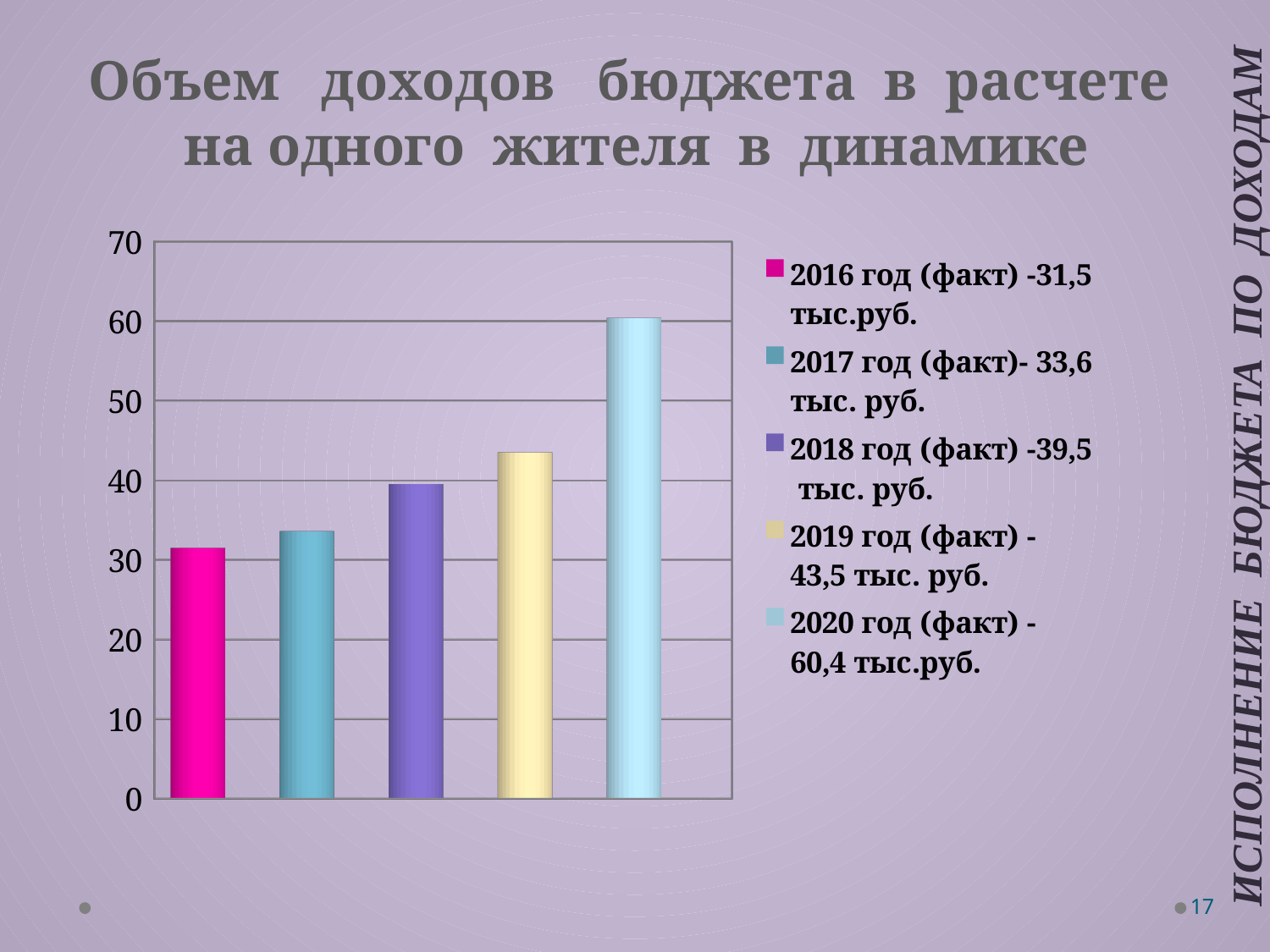
Which year has the highest value? 2020 год (факт) How many bars are plotted in the chart? 5 What is the difference between the 2020 value and the 2016 value? 28,9 тыс. руб. Which year has the lowest value? 2016 год (факт) What is the value for 2018 год (факт)? 39,5 тыс. руб. What is the value for 2016 год (факт)? 31,5 тыс.руб. What colour is the bar for 2016 год (факт)? pink (magenta) What is the value for 2020 год (факт)? 60,4 тыс.руб. What type of chart is shown on the slide? bar chart Which is larger, the value for 2019 or the value for 2018? 2019 How many entries does the legend list? 5 Do the values rise or fall from 2016 to 2020? rise